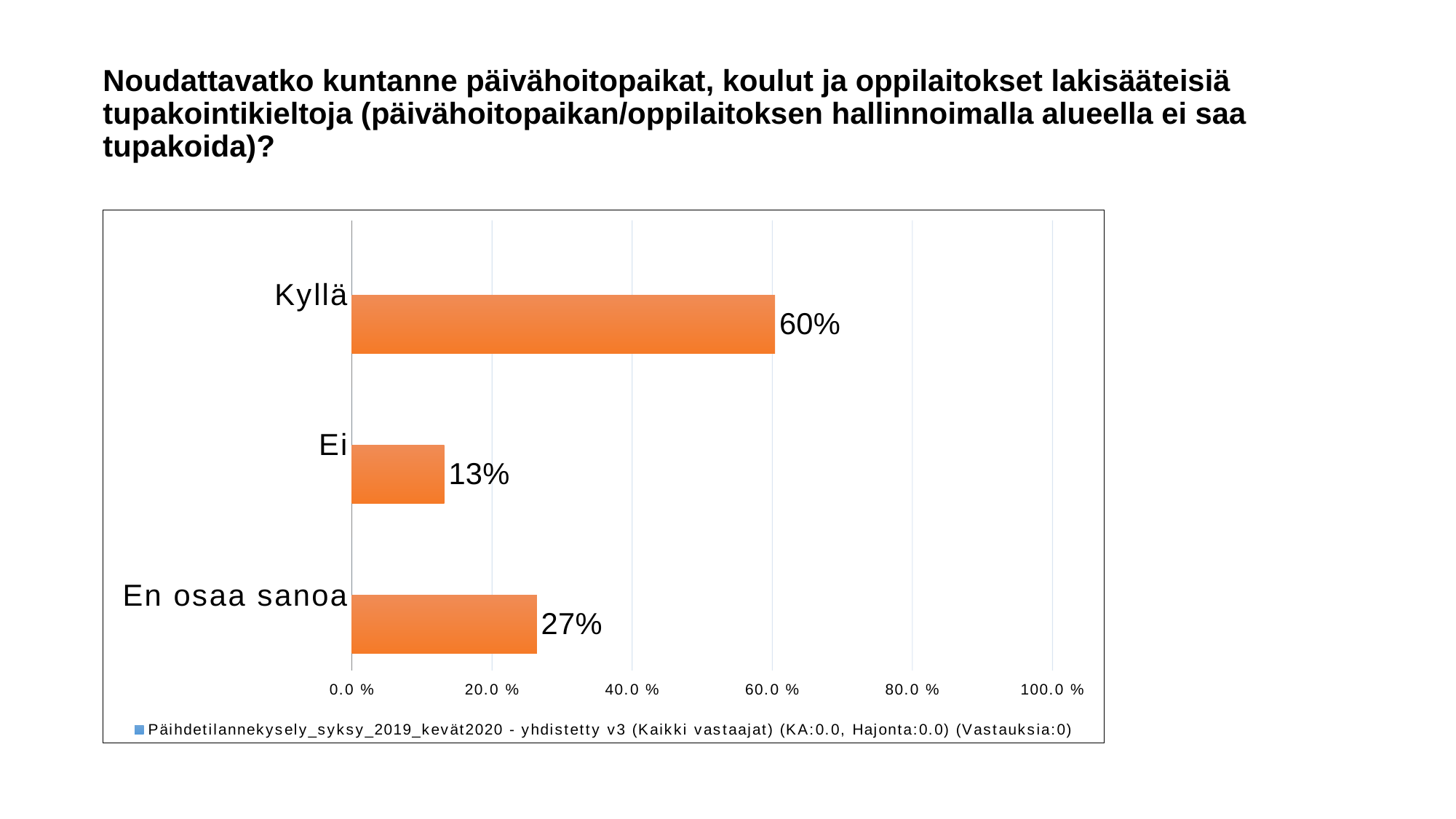
Which category has the lowest value? Ei Is the value for Kyllä greater or less than 40.0 %? greater What is the value for En osaa sanoa? 27% What is the difference between the values for Kyllä and Ei? 47% What kind of chart is shown on the slide? bar chart What is the value for Ei? 13% How many series does the legend list? 1 Which category has the highest value? Kyllä How many categories are shown in the chart? 3 What is the difference between the values for En osaa sanoa and Ei? 14% Which is larger, the value for En osaa sanoa or the value for Ei? En osaa sanoa What is the value for Kyllä? 60%